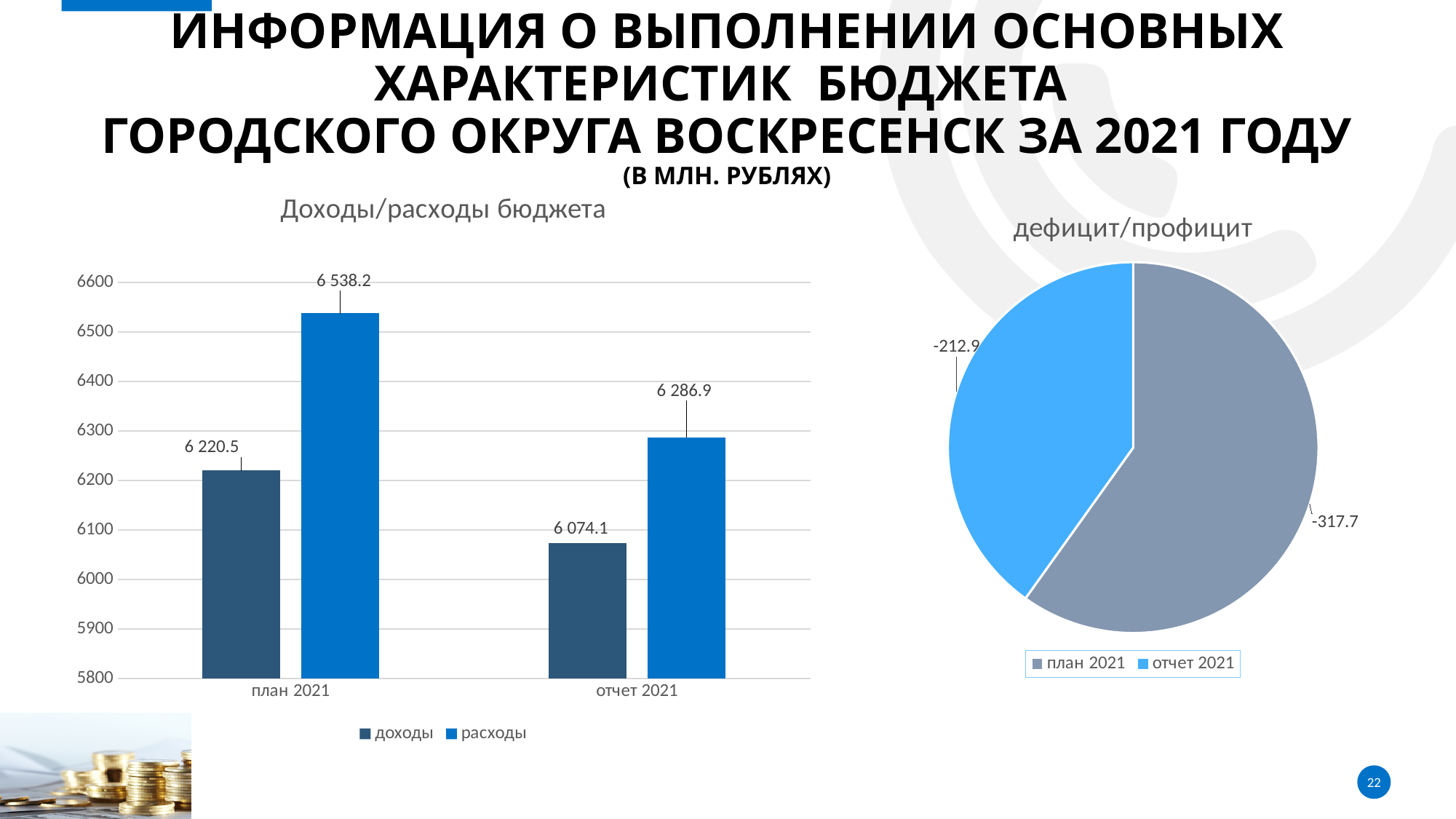
In the chart 'Доходы/расходы бюджета', what is the value of доходы for план 2021? 6 220.5 What kind of chart is 'дефицит/профицит'? pie chart In the chart 'Доходы/расходы бюджета', what is the difference between расходы and доходы for план 2021? 317.7 In the pie chart 'дефицит/профицит', what is the value for план 2021? -317.7 In the chart 'Доходы/расходы бюджета', which bar has the highest value? расходы, план 2021 In the chart 'Доходы/расходы бюджета', what is the value of доходы for отчет 2021? 6 074.1 How many series does the legend of the chart 'Доходы/расходы бюджета' list? 2 In the chart 'Доходы/расходы бюджета', which is larger: доходы for план 2021 or доходы for отчет 2021? доходы for план 2021 In the chart 'Доходы/расходы бюджета', what is the value of расходы for отчет 2021? 6 286.9 In the chart 'Доходы/расходы бюджета', what is the value of расходы for план 2021? 6 538.2 In the pie chart 'дефицит/профицит', what is the value for отчет 2021? -212.9 In the chart 'Доходы/расходы бюджета', which bar has the lowest value? доходы, отчет 2021